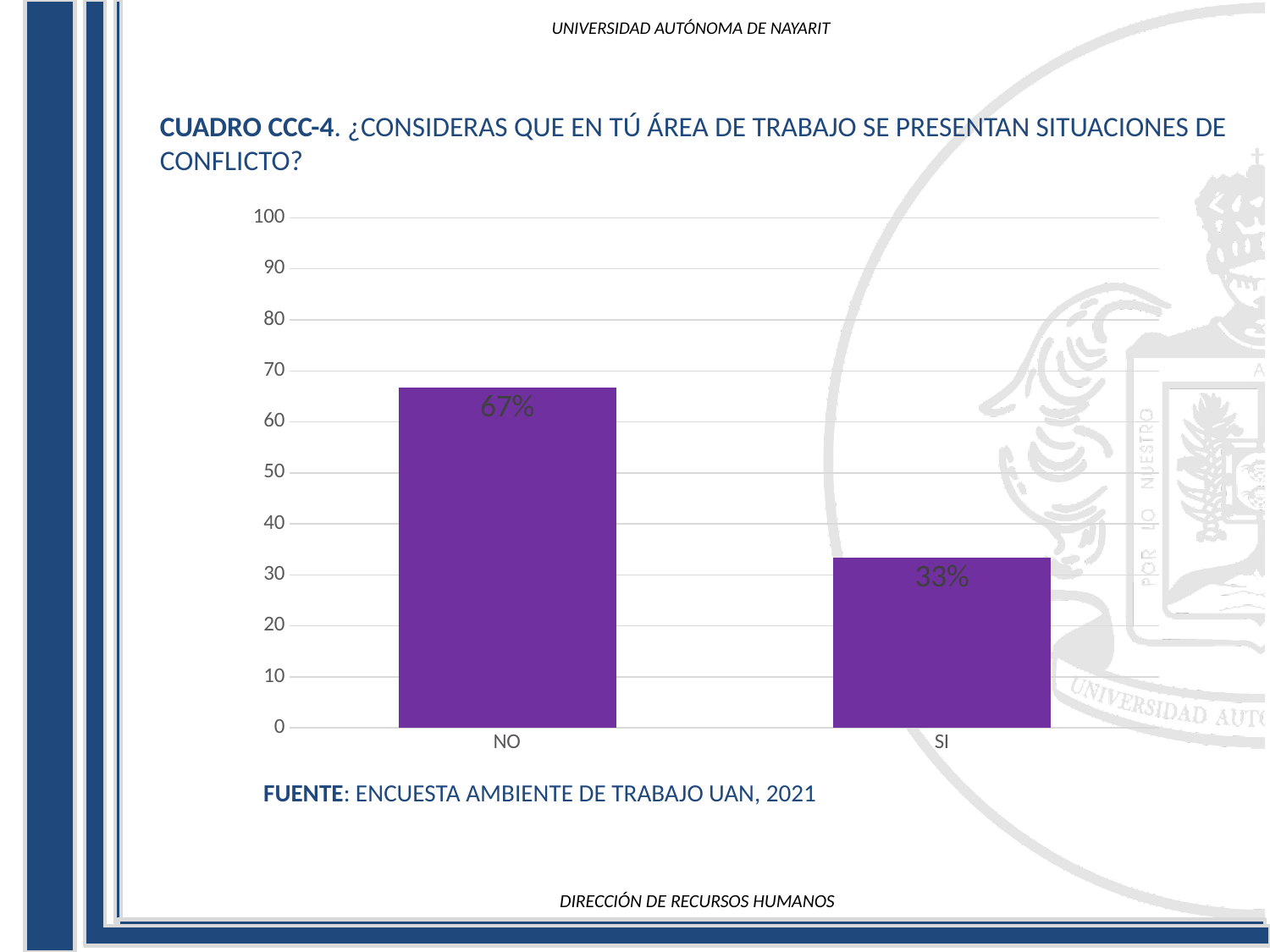
What is the value for NO? 67% What kind of chart is shown on the slide? bar chart Which category has the highest value? NO Is the value for NO greater or less than 60? greater What is the source cited below the chart? ENCUESTA AMBIENTE DE TRABAJO UAN, 2021 How many categories are shown on the x axis? 2 What colour are the bars in the chart? purple Is the value for SI greater or less than 40? less What is the value for SI? 33% Which is larger, the value for NO or the value for SI? NO Which category has the lowest value? SI What is the difference between the values for NO and SI? 34%